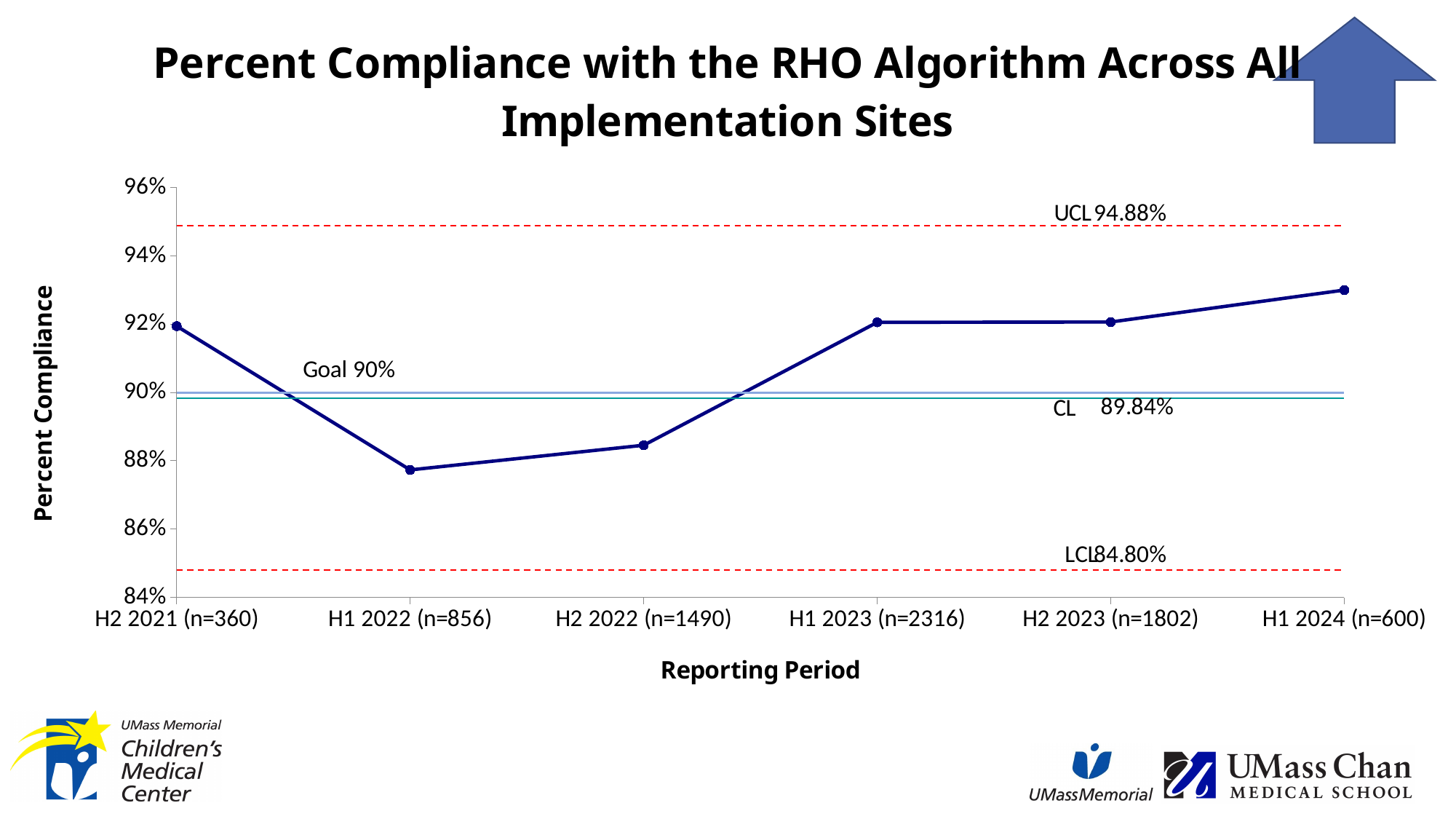
Is the percent compliance for H1 2024 (n=600) greater or less than 92%? greater Is the percent compliance for H1 2022 (n=856) greater or less than 88%? less Is the percent compliance for H2 2022 (n=1490) greater or less than 90%? less What kind of chart is shown on the slide? line chart Which reporting period has the highest percent compliance? H1 2024 (n=600) What is the value of the lower control limit (LCL) shown on the chart? 84.80% What is the goal value marked on the chart? 90% Which has higher percent compliance, H2 2021 (n=360) or H2 2022 (n=1490)? H2 2021 (n=360) Which reporting period has the lowest percent compliance? H1 2022 (n=856) What is the value of the upper control limit (UCL) shown on the chart? 94.88% How many reporting periods are plotted on the x axis? 6 What is the value of the center line (CL) shown on the chart? 89.84%